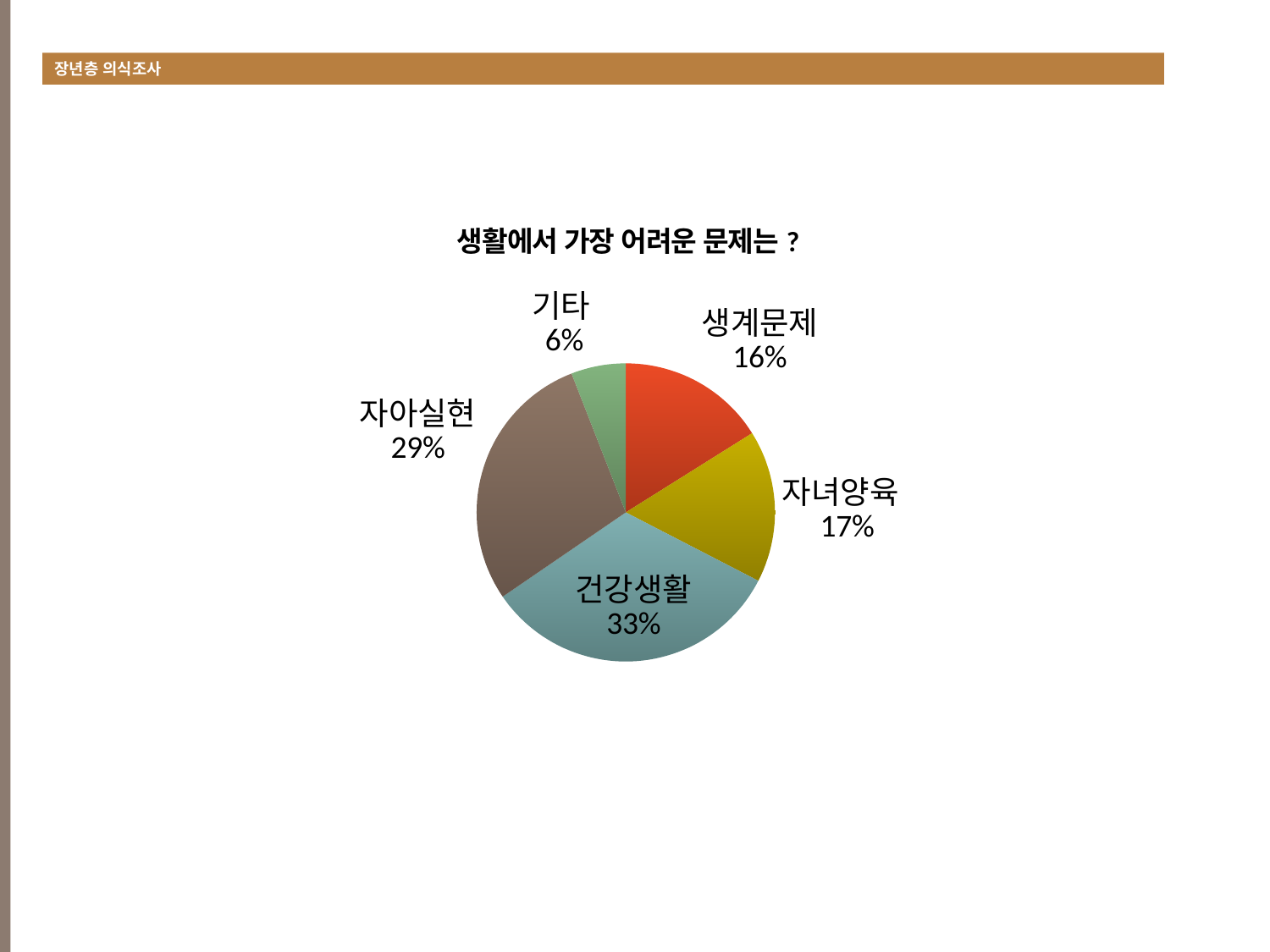
What is the value for 기타? 6% What is the value for 자녀양육? 17% Which is larger, 자아실현 or 생계문제? 자아실현 What share of the pie does 건강생활 have? 33% How many categories are shown in the pie chart? 5 What type of chart is shown on the slide? pie chart What is the value for 생계문제? 16% What is the title of the chart? 생활에서 가장 어려운 문제는 ? Which category has the smallest slice? 기타 Which category has the largest slice? 건강생활 What is the difference between the values for 건강생활 and 자아실현? 4% What share of the pie does 자아실현 have? 29%